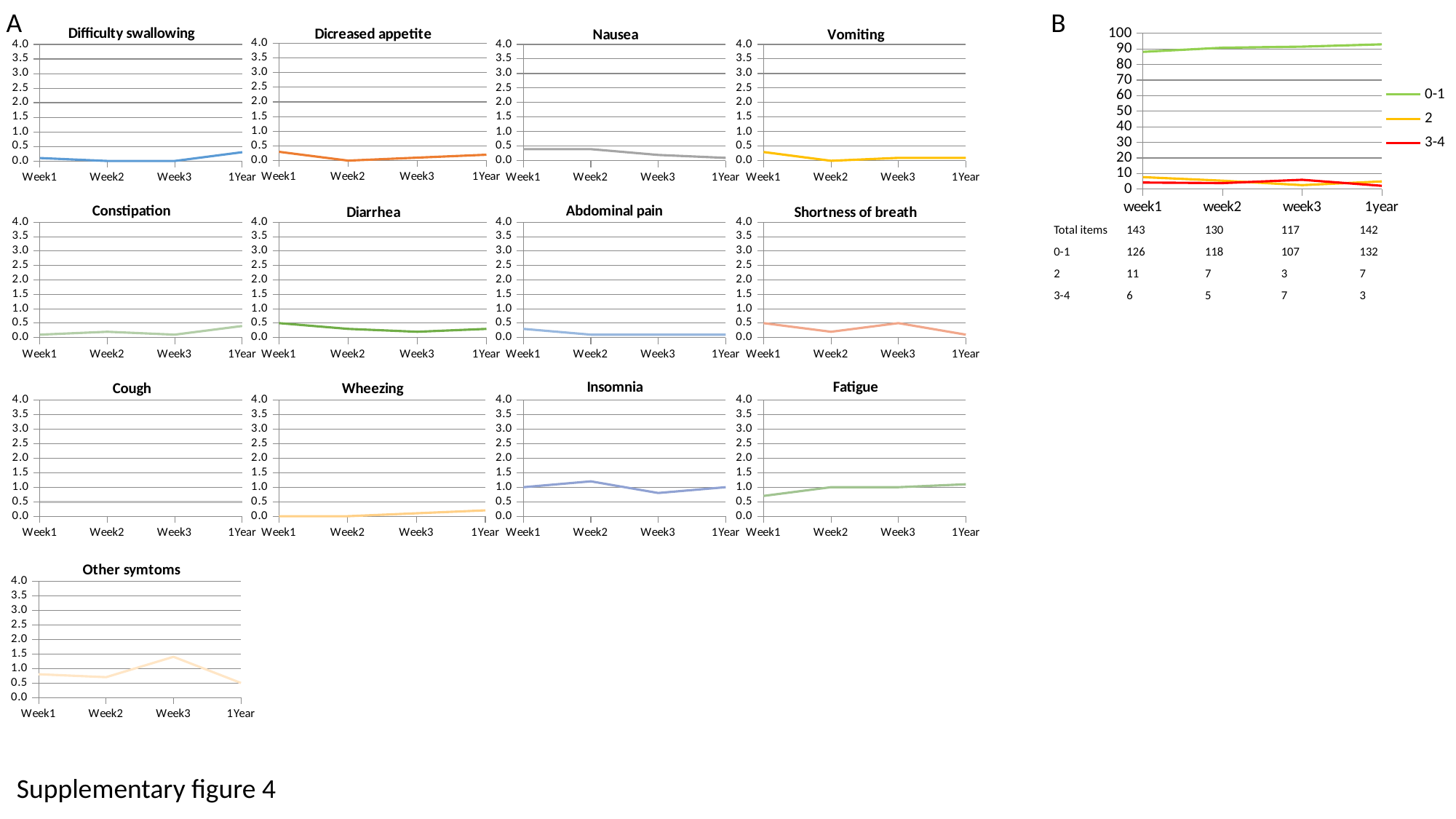
In the "Cough" chart in panel A, is the value at Week1 greater or less than 1.0? less In the chart in panel B, is the 0-1 line at 1year greater or less than 80? greater In the table under the chart in panel B, what is the value for 0-1 at week1? 126 In the table under the chart in panel B, which is larger for the 3-4 row: week2 or week3? week3 In the "Fatigue" chart in panel A, does the line rise or fall from Week1 to 1Year? rise In the table under the chart in panel B, what is the value of Total items at week3? 117 How many series does the legend of the chart in panel B list? 3 In the table under the chart in panel B, what is the difference between Total items at week1 and at week3? 26 In the table under the chart in panel B, at which time point is the value for row 2 lowest? week3 How many time points are plotted along the x axis of the "Fatigue" chart in panel A? 4 What kind of chart is the "Difficulty swallowing" chart in panel A? line chart In the table under the chart in panel B, which time point has the highest Total items? week1